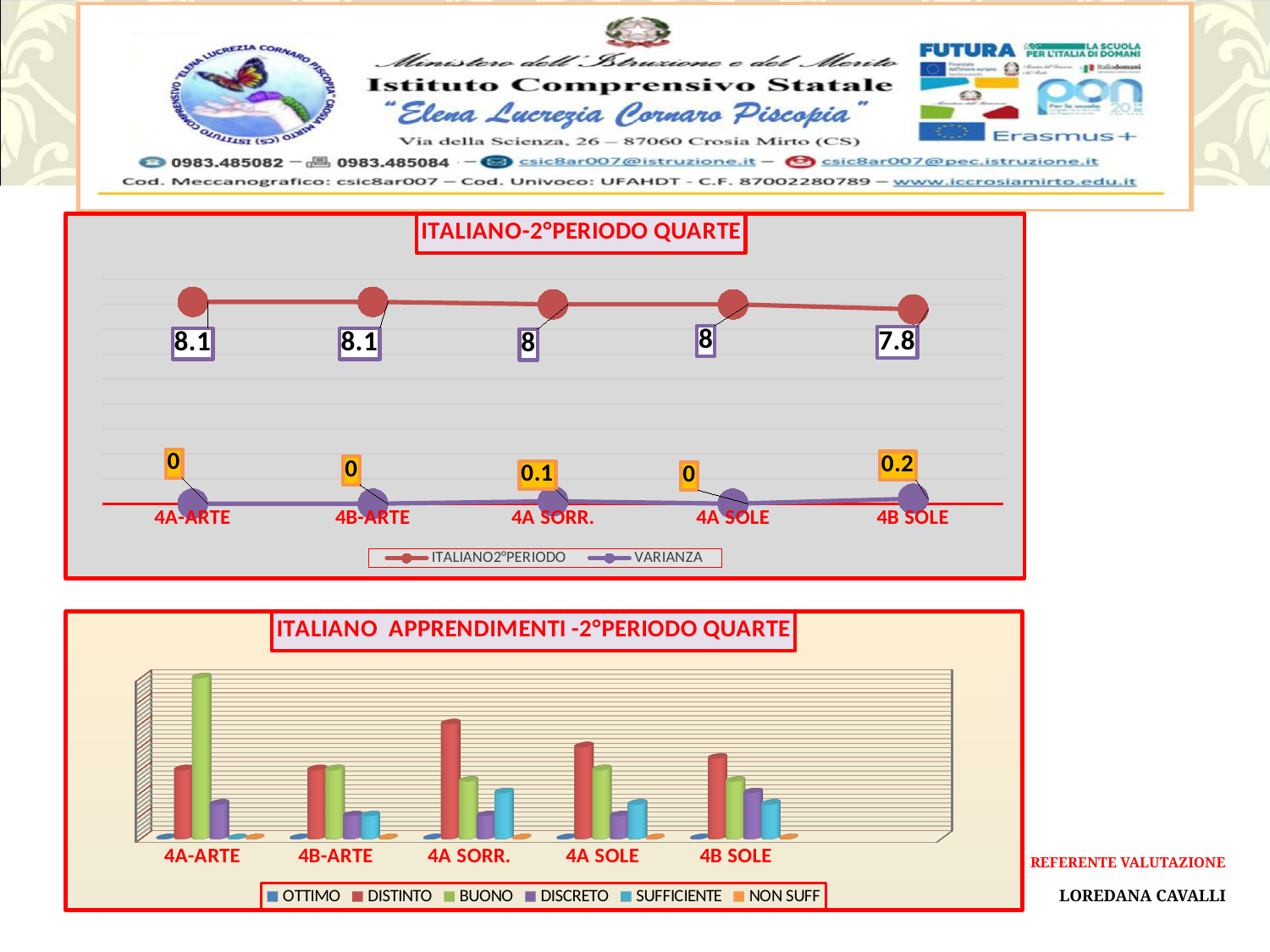
In the chart titled "ITALIANO-2°PERIODO QUARTE", what is the difference between the ITALIANO2°PERIODO values for 4A-ARTE and 4B SOLE? 0.3 In the chart titled "ITALIANO-2°PERIODO QUARTE", what is the VARIANZA value for 4A SORR.? 0.1 In the chart titled "ITALIANO-2°PERIODO QUARTE", which category has the highest VARIANZA value? 4B SOLE In the chart titled "ITALIANO-2°PERIODO QUARTE", what is the ITALIANO2°PERIODO value for 4B SOLE? 7.8 In the chart titled "ITALIANO-2°PERIODO QUARTE", does the ITALIANO2°PERIODO series rise or fall from 4A-ARTE to 4B SOLE? fall In the chart titled "ITALIANO-2°PERIODO QUARTE", how many series does the legend list? 2 In the chart titled "ITALIANO APPRENDIMENTI -2°PERIODO QUARTE", how many series does the legend list? 6 In the chart titled "ITALIANO-2°PERIODO QUARTE", which category has the lowest ITALIANO2°PERIODO value? 4B SOLE In the chart titled "ITALIANO APPRENDIMENTI -2°PERIODO QUARTE", which is larger for 4A-ARTE: BUONO or DISTINTO? BUONO What kind of chart is the one titled "ITALIANO-2°PERIODO QUARTE"? line chart In the chart titled "ITALIANO-2°PERIODO QUARTE", what is the ITALIANO2°PERIODO value for 4A-ARTE? 8.1 What kind of chart is the one titled "ITALIANO APPRENDIMENTI -2°PERIODO QUARTE"? bar chart